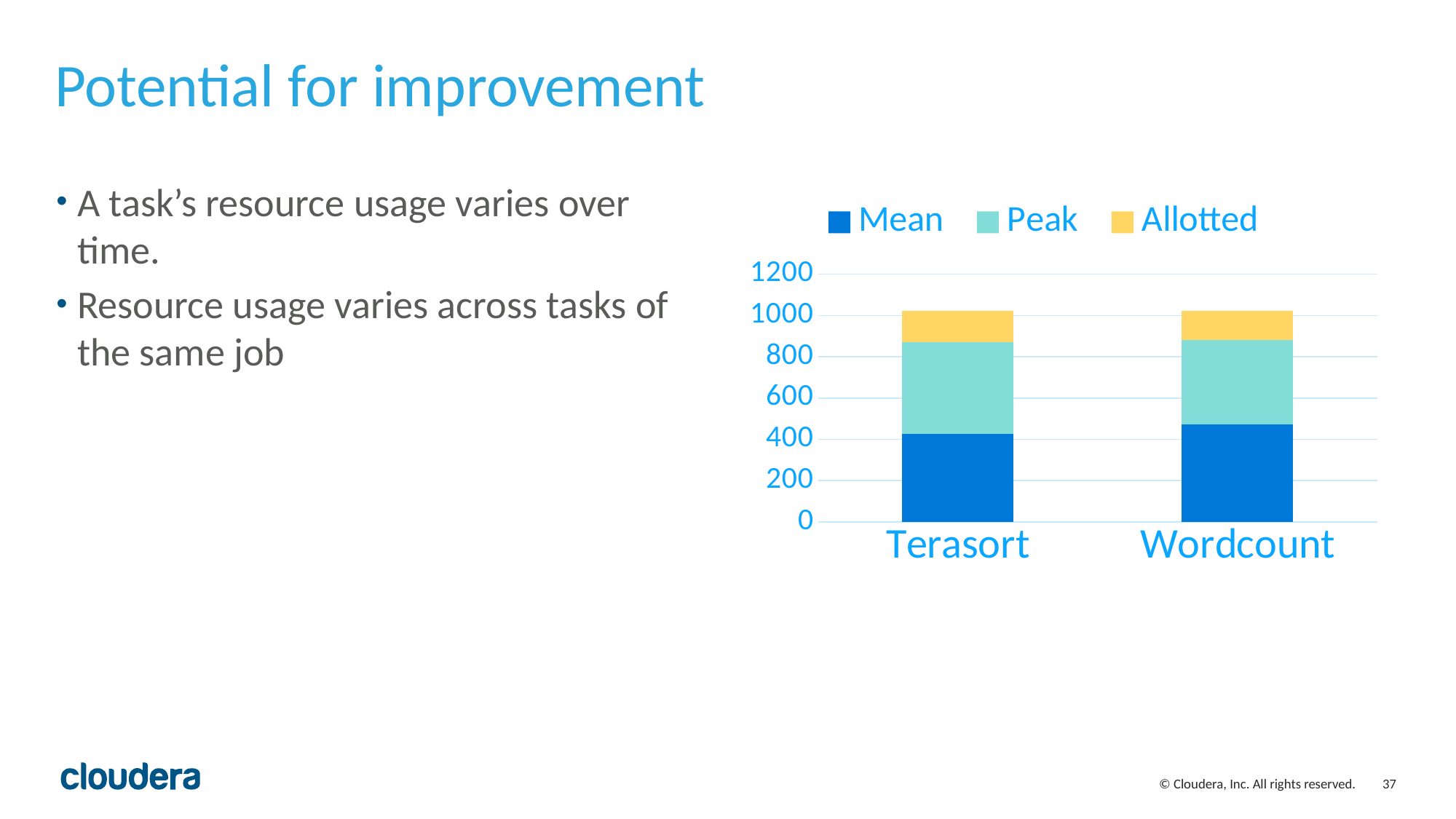
Is the total height of the Wordcount stacked bar greater or less than 800? greater What kind of chart is shown on the slide? stacked bar chart What are the series names listed in the chart's legend? Mean, Peak, Allotted Is the Mean value for Wordcount greater or less than 400? greater Which category has the larger Mean value, Terasort or Wordcount? Wordcount What is the highest value shown on the chart's y axis? 1200 How many categories are shown on the x axis of the chart? 2 Is the Mean value for Terasort greater or less than 600? less Which series is drawn at the bottom of each stacked bar? Mean How many series does the chart's legend list? 3